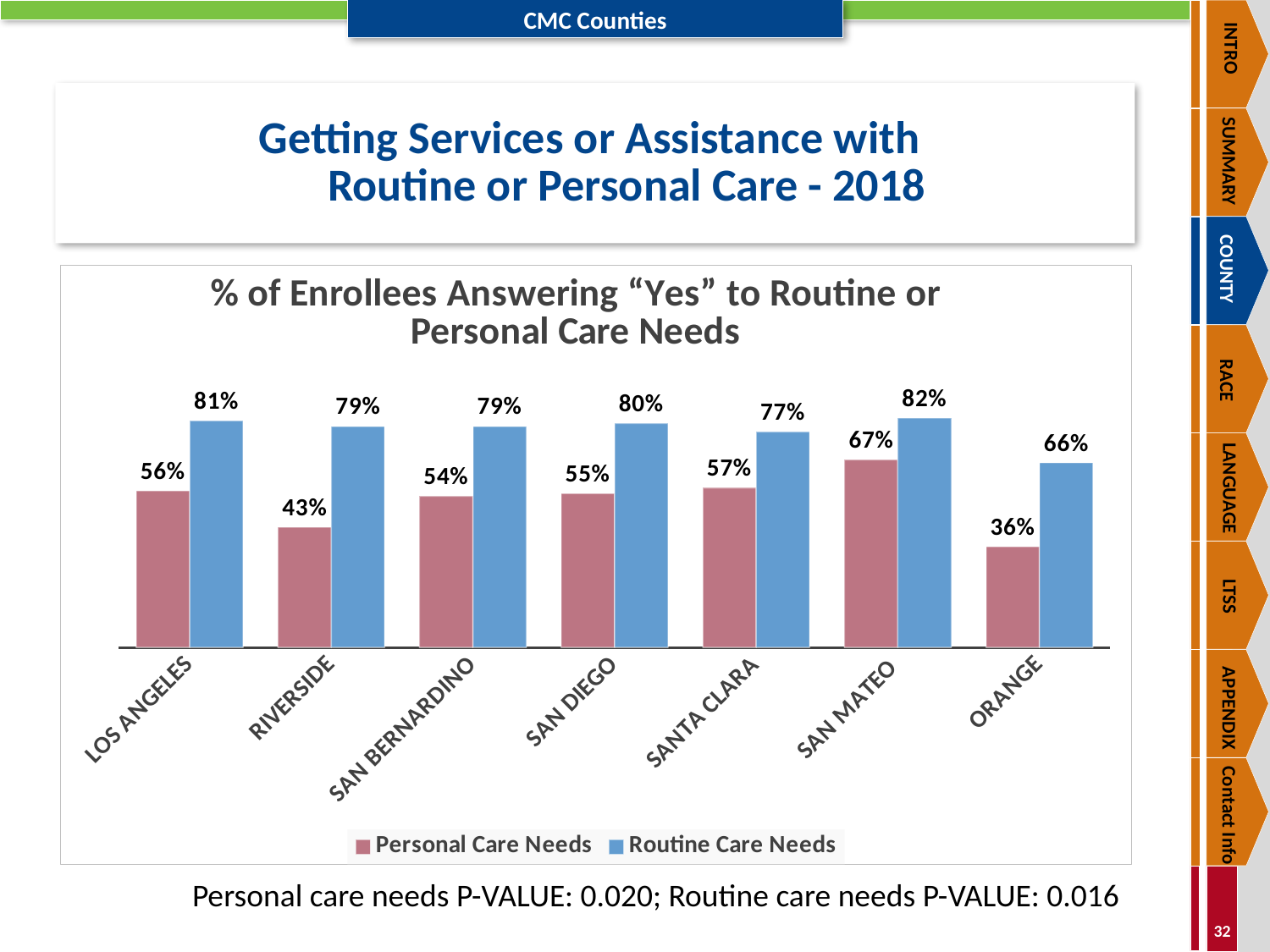
What is the Routine Care Needs value for Orange? 66% What is the difference between the Routine Care Needs and Personal Care Needs values for Los Angeles? 25% Which county has the highest Routine Care Needs value? San Mateo What kind of chart is shown? Bar chart What is the Personal Care Needs value for Riverside? 43% What is the Personal Care Needs value for San Mateo? 67% Which series is shown in blue? Routine Care Needs How many series does the legend list? 2 How many counties are shown on the x axis? 7 What is the title of the chart? % of Enrollees Answering "Yes" to Routine or Personal Care Needs Which is larger: the Personal Care Needs value for San Diego or for Santa Clara? Santa Clara Which county has the lowest Personal Care Needs value? Orange